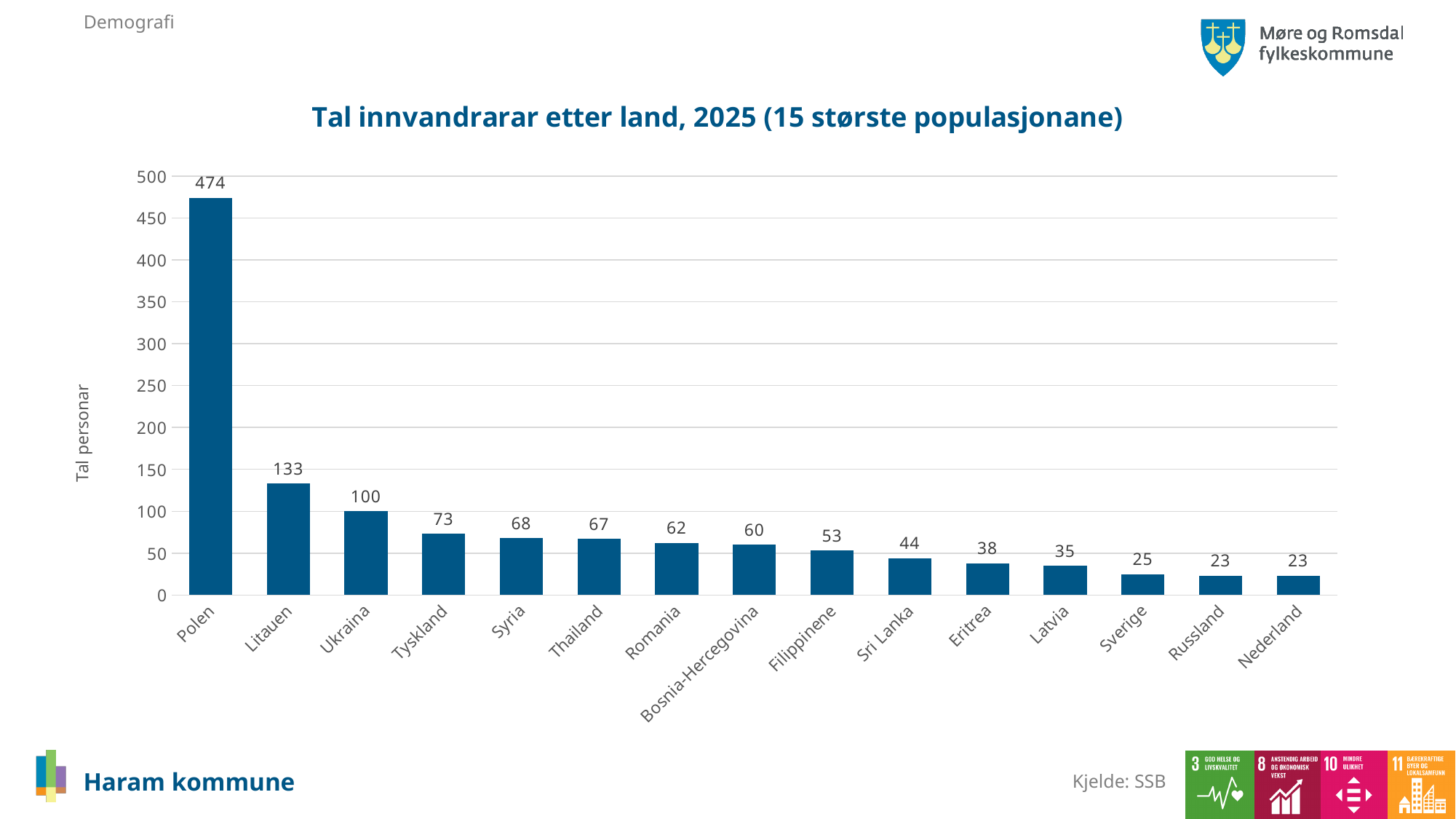
How many countries are shown on the chart? 15 Which country has the highest value? Polen What kind of chart is this? Bar chart What is the value for Polen? 474 Do the values rise or fall from left to right along the x axis? Fall What is the value for Ukraina? 100 Which is larger, the value for Syria or the value for Thailand? Syria Which country has the lowest value, Sverige or Latvia? Sverige What is the title of the chart? Tal innvandrarar etter land, 2025 (15 største populasjonane) What is the value for Bosnia-Hercegovina? 60 What is the difference between the values for Polen and Litauen? 341 What is the difference between the values for Litauen and Ukraina? 33